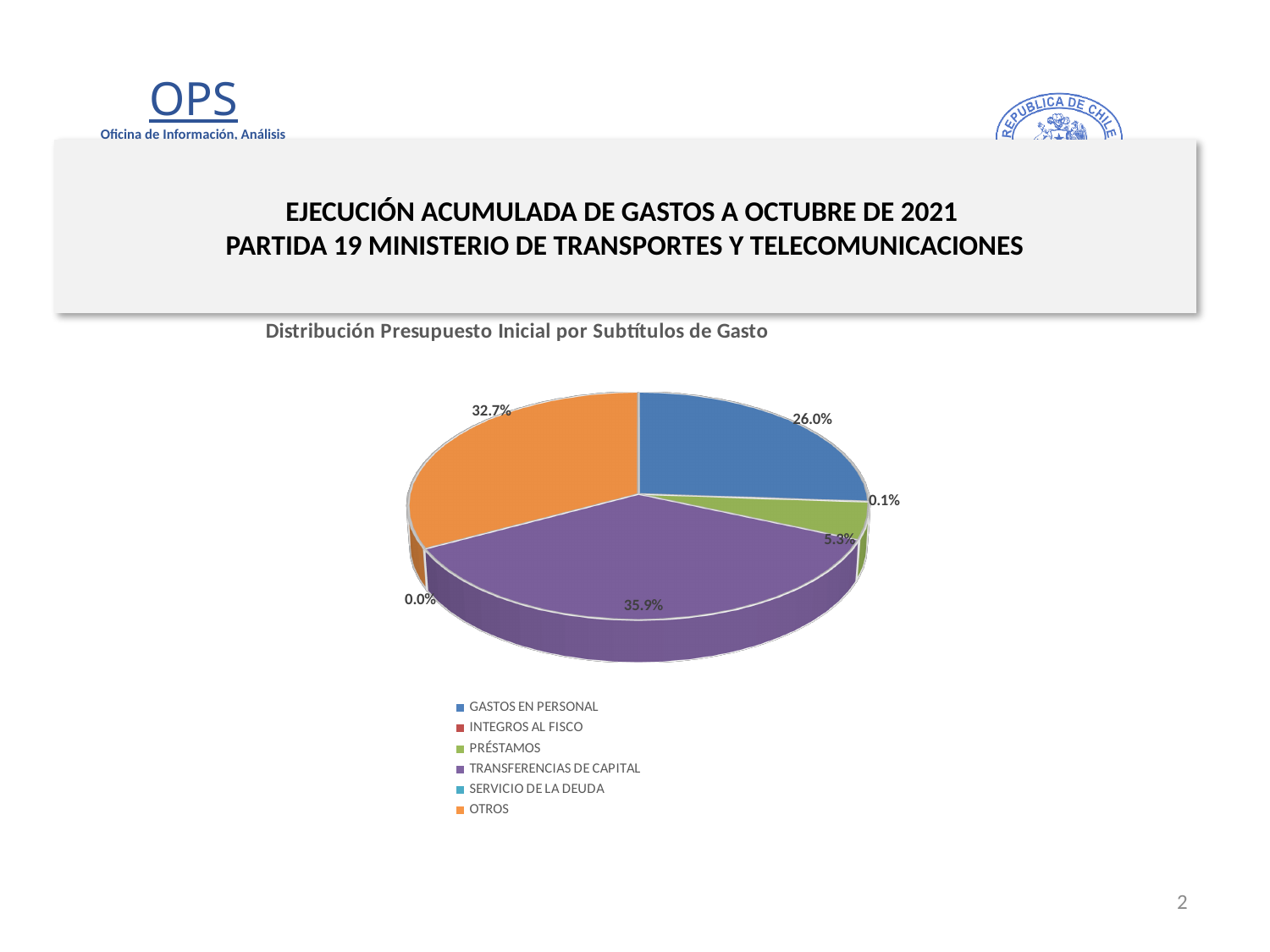
What share of the pie does TRANSFERENCIAS DE CAPITAL represent? 35.9% What kind of chart is shown on the slide? pie chart What share of the pie does OTROS represent? 32.7% Which category has the largest share of the pie? TRANSFERENCIAS DE CAPITAL Which is larger, the share of OTROS or the share of GASTOS EN PERSONAL? OTROS What is the title of the chart? Distribución Presupuesto Inicial por Subtítulos de Gasto What share of the pie does INTEGROS AL FISCO represent? 0.1% Which category has the smallest share of the pie? SERVICIO DE LA DEUDA What is the difference between the shares of TRANSFERENCIAS DE CAPITAL and GASTOS EN PERSONAL? 9.9% How many entries does the legend list? 6